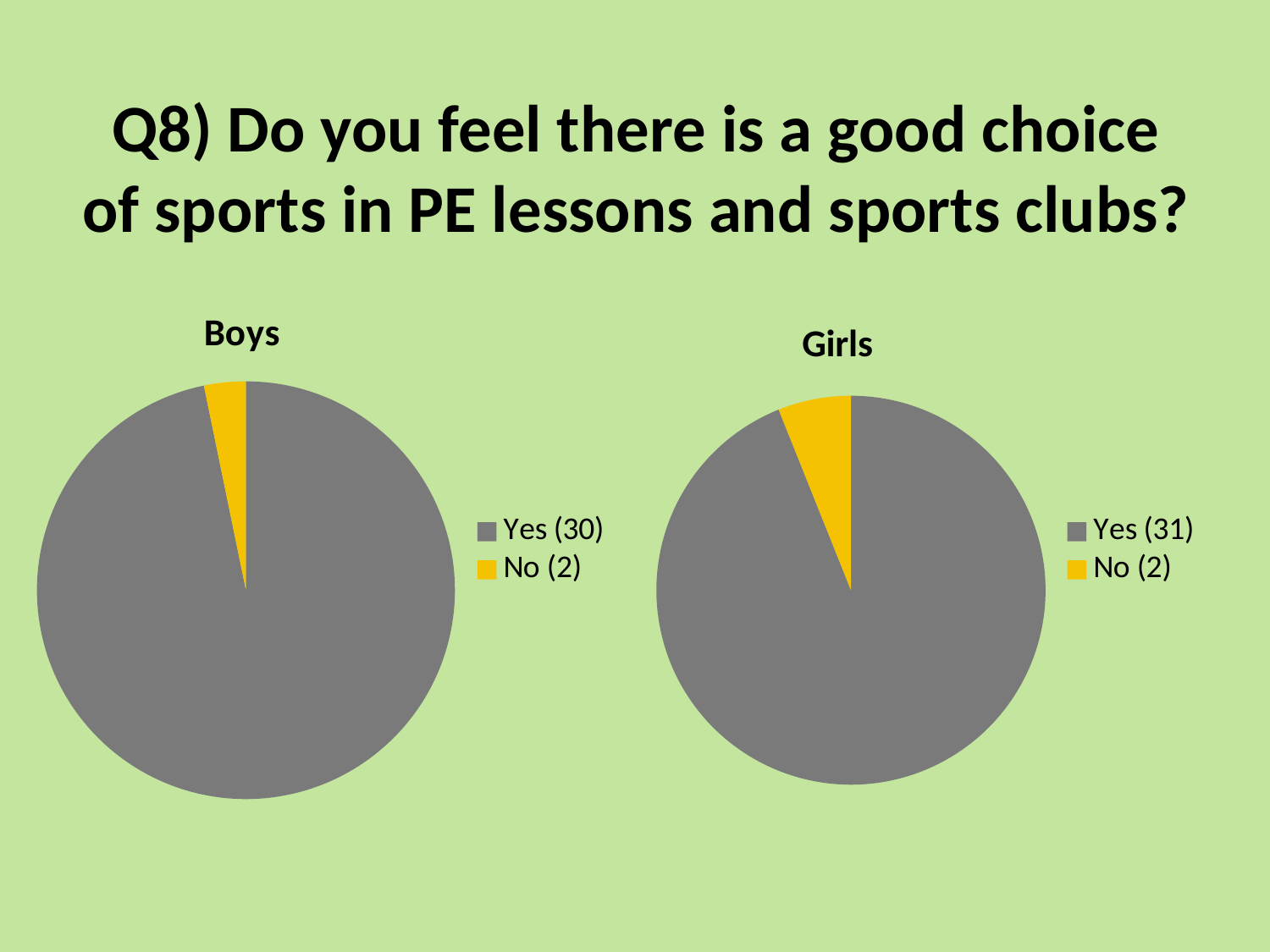
What kind of chart is the Boys chart? pie chart In the Girls chart, how many girls answered Yes? 31 In the Boys chart, how many boys answered No? 2 How many slices does the Girls pie chart have? 2 In the Boys chart, what colour is the No slice? yellow In the Boys chart, which response has the smallest slice? No In the Girls chart, how many girls answered No? 2 In the Girls chart, which response has the largest slice? Yes Which is larger: the number of Yes responses in the Girls chart or in the Boys chart? Girls In the Boys chart, what is the difference between the number of Yes and No responses? 28 In the Boys chart, what is the total number of responses? 32 In the Boys chart, how many boys answered Yes? 30